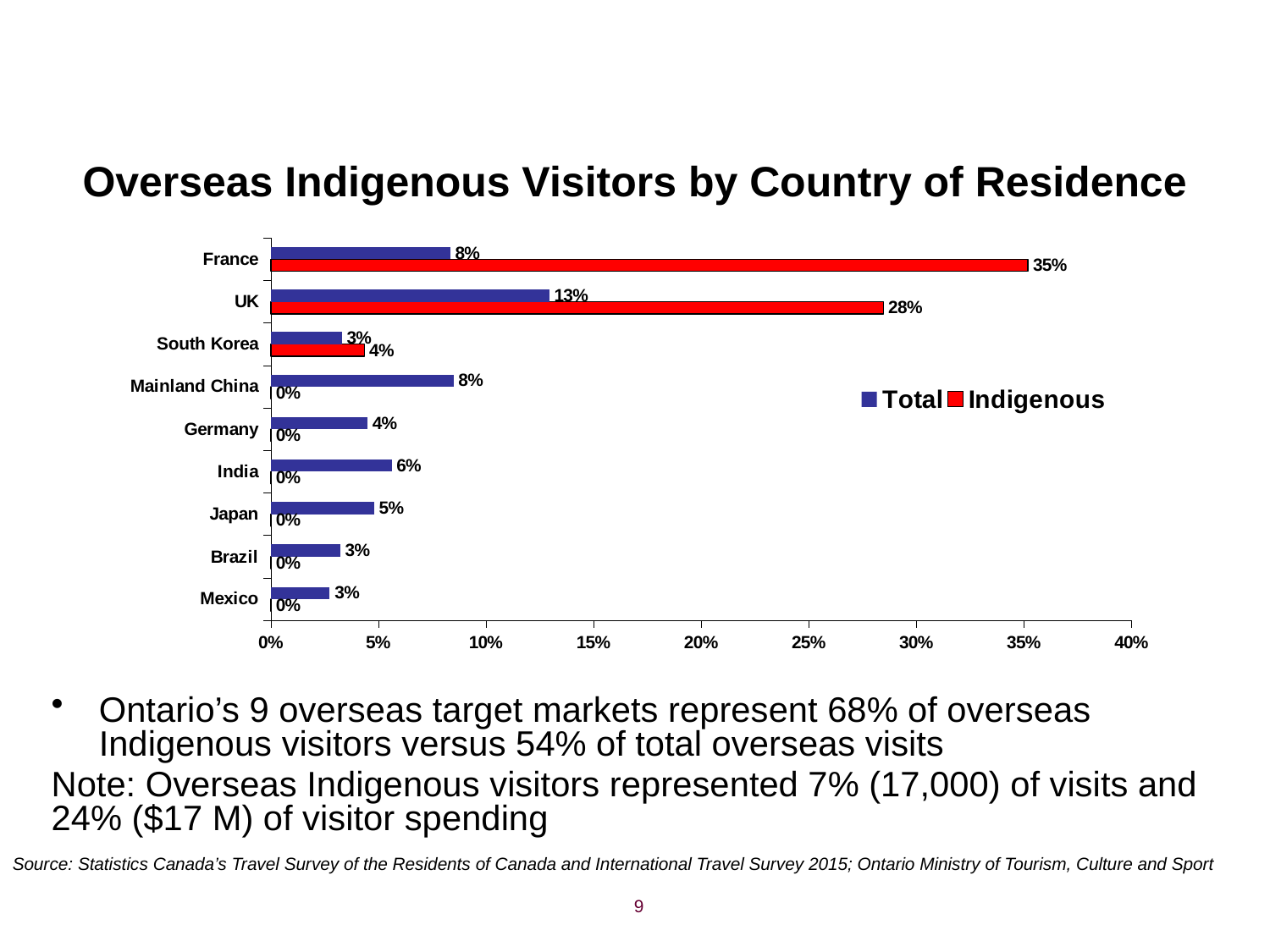
Is the Indigenous value for the UK greater or less than 25%? greater Which country has the highest Total value? UK Which country has the highest Indigenous value? France What is the difference between the Indigenous values for France and the UK? 7% What is the Indigenous value for South Korea? 4% What kind of chart is shown on the slide? Bar chart How many countries are shown on the chart? 9 How many series does the legend list? 2 What is the Total value for India? 6% Which is larger for Mainland China, the Total value or the Indigenous value? Total What is the Indigenous value for France? 35% What is the Total value for the UK? 13%